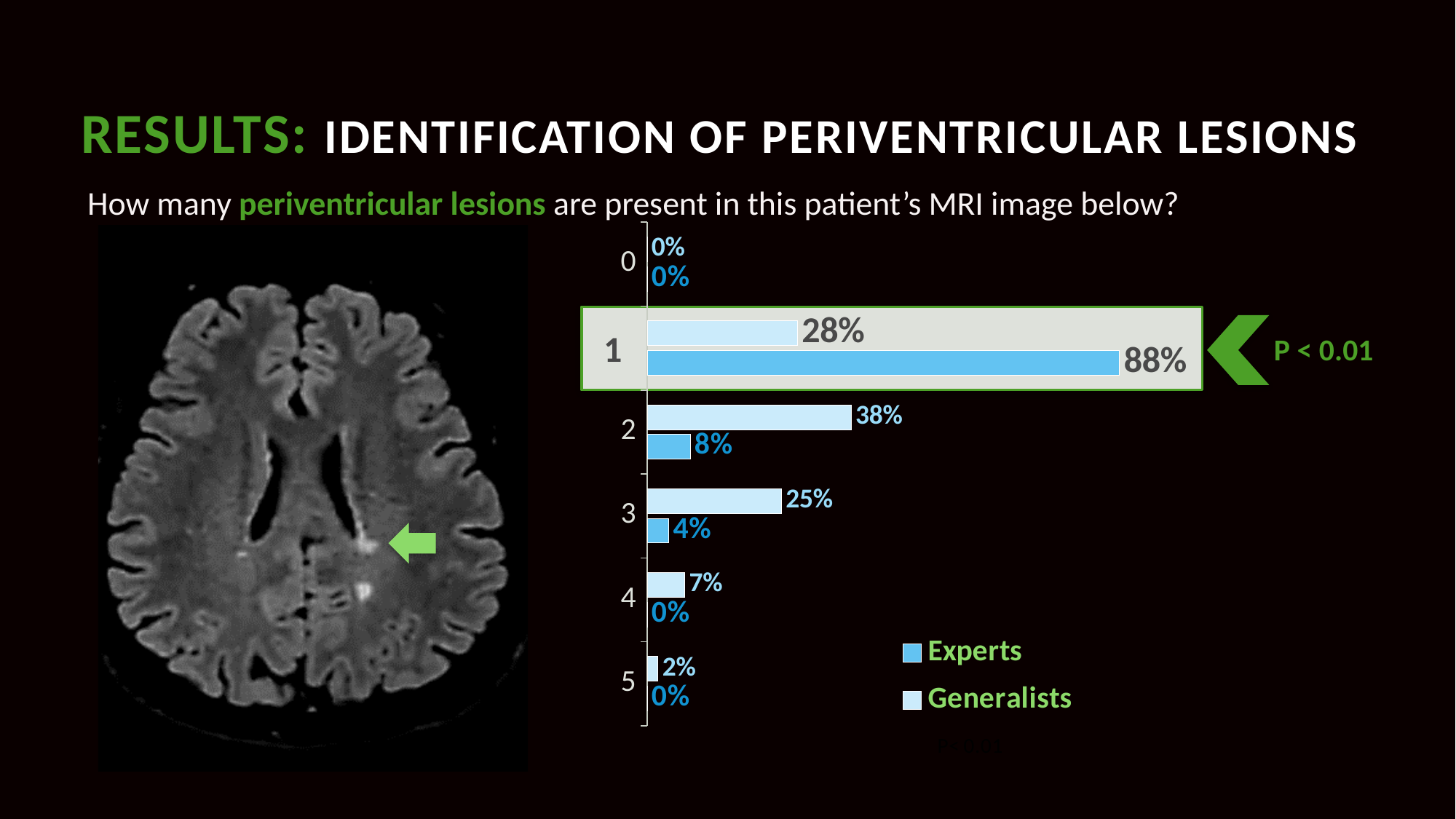
Which answer category has the highest value for Generalists? 2 For answer 3, which group has the larger value, Experts or Generalists? Generalists What type of chart is shown on the slide? Bar chart What p-value is annotated next to the highlighted answer 1 on the chart? P < 0.01 Which answer category has the highest value for Experts? 1 How many series does the legend list? 2 How many answer categories are shown on the chart? 6 What percentage of Generalists answered 3 lesions? 25% What percentage of Experts answered 1 lesion? 88% What percentage of Generalists answered 2 lesions? 38% What percentage of Experts answered 2 lesions? 8% What is the difference between the Experts and Generalists values for answer 1? 60%